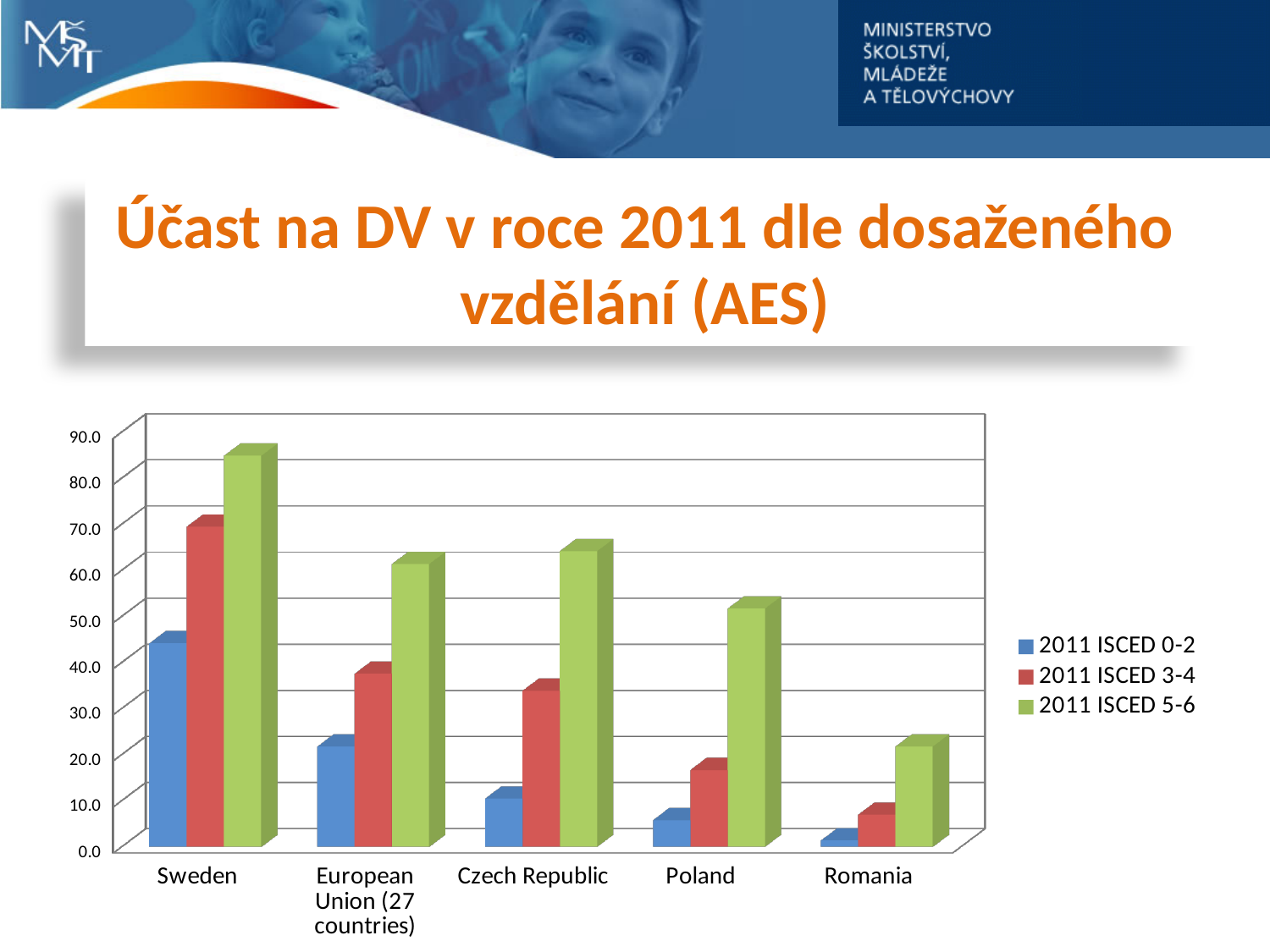
How many countries or regions are shown on the x axis of the chart? 5 Is the 2011 ISCED 5-6 value for Romania greater or less than 30? less Is the 2011 ISCED 5-6 value for Sweden greater or less than 80? greater How many series does the chart legend list? 3 Which category has the highest value for the 2011 ISCED 5-6 series? Sweden What kind of chart is shown on the slide? bar chart Is the 2011 ISCED 0-2 value for Sweden greater or less than 40? greater Does the 2011 ISCED 0-2 series rise or fall moving from Sweden to Romania along the x axis? fall Which colour represents the 2011 ISCED 3-4 series in the chart? red Which is larger, the 2011 ISCED 3-4 value for Sweden or for European Union (27 countries)? Sweden Which category has the lowest value for the 2011 ISCED 0-2 series? Romania